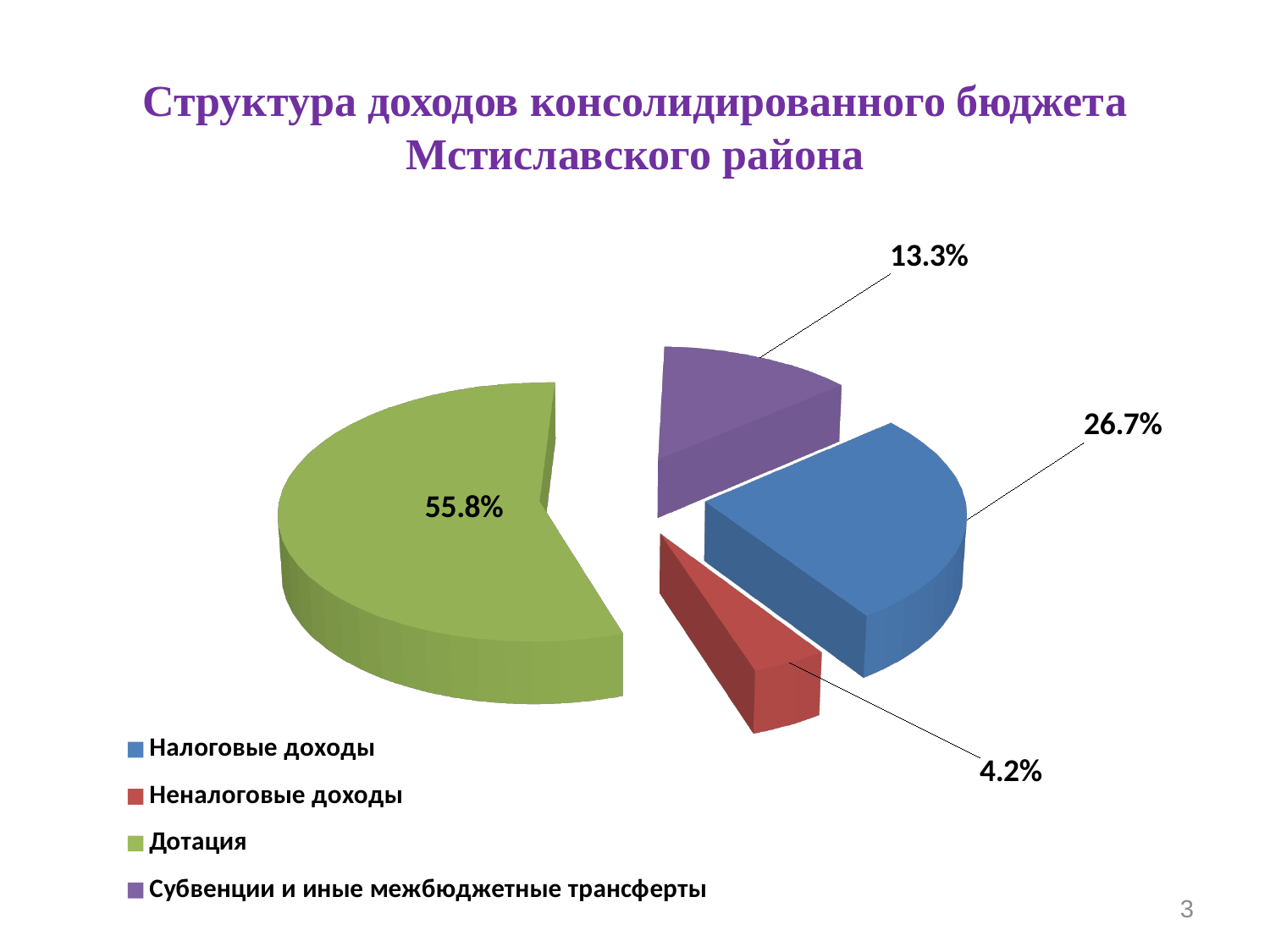
What is the value for Налоговые доходы? 26.7% Which category has the smallest share? Неналоговые доходы What is the difference between the shares of Дотация and Субвенции и иные межбюджетные трансферты? 42.5% What colour is the slice for Дотация? Green How many categories are shown in the pie chart? 4 What is the value for Неналоговые доходы? 4.2% Which is larger, Налоговые доходы or Субвенции и иные межбюджетные трансферты? Налоговые доходы What share of the pie does Дотация have? 55.8% What kind of chart is shown on the slide? Pie chart What is the value for Субвенции и иные межбюджетные трансферты? 13.3% What is the difference between the shares of Налоговые доходы and Неналоговые доходы? 22.5% Which category has the largest share? Дотация